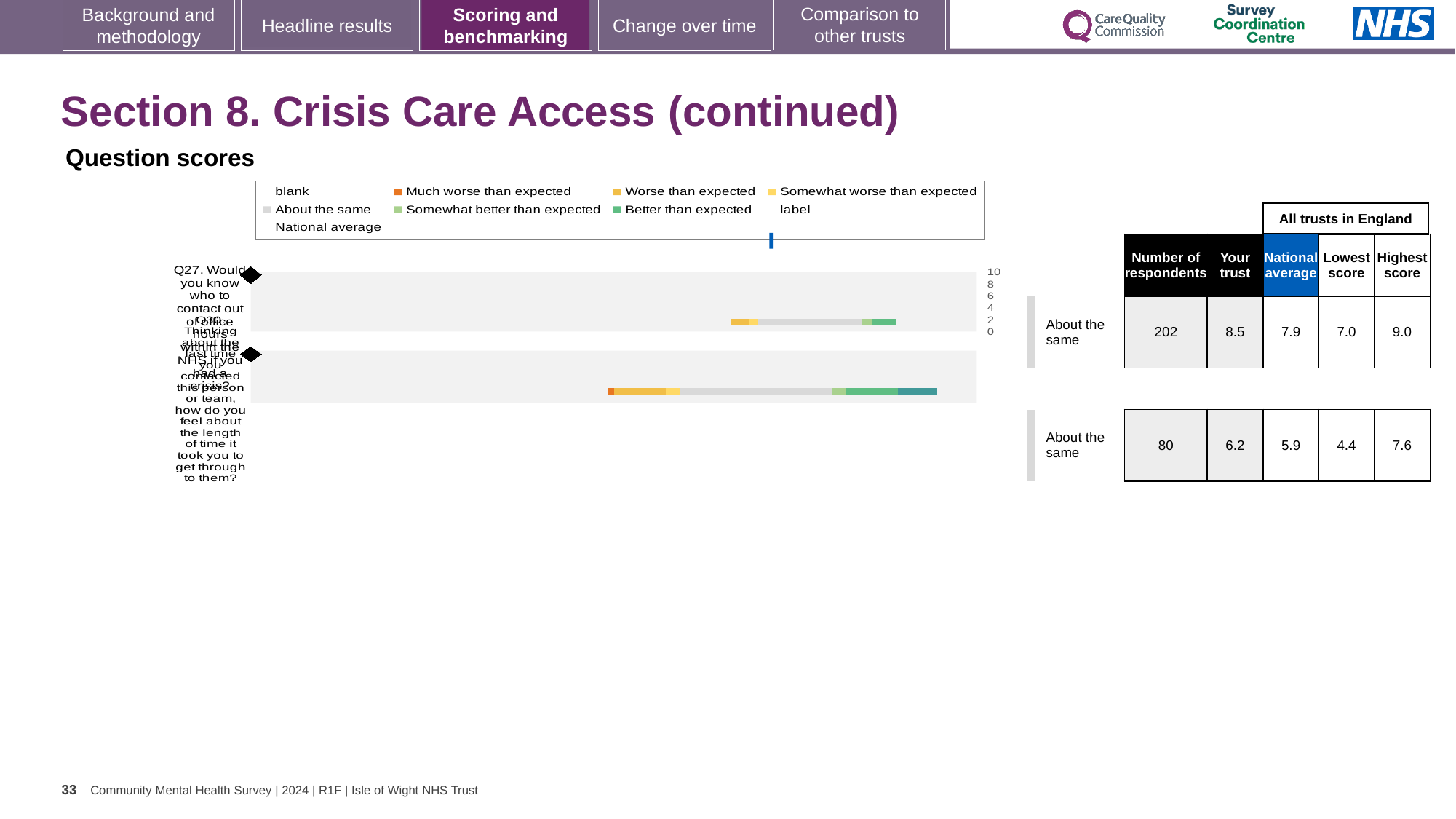
What kind of chart is used to show the question scores? Bar chart How many respondents answered Q27? 202 What is the difference between the 'Your trust' score and the national average for Q27? 0.6 How many questions are plotted in the chart? 2 What is the lowest score among all trusts in England for Q30? 4.4 What is the difference between the highest and lowest scores for Q30? 3.2 What is the national average score for Q30? 5.9 How many respondents answered Q30? 80 What is the highest score among all trusts in England for Q27? 9.0 Which question has the higher 'Your trust' score, Q27 or Q30? Q27 What benchmark category is shown for Q30? About the same What is the 'Your trust' score for Q27? 8.5